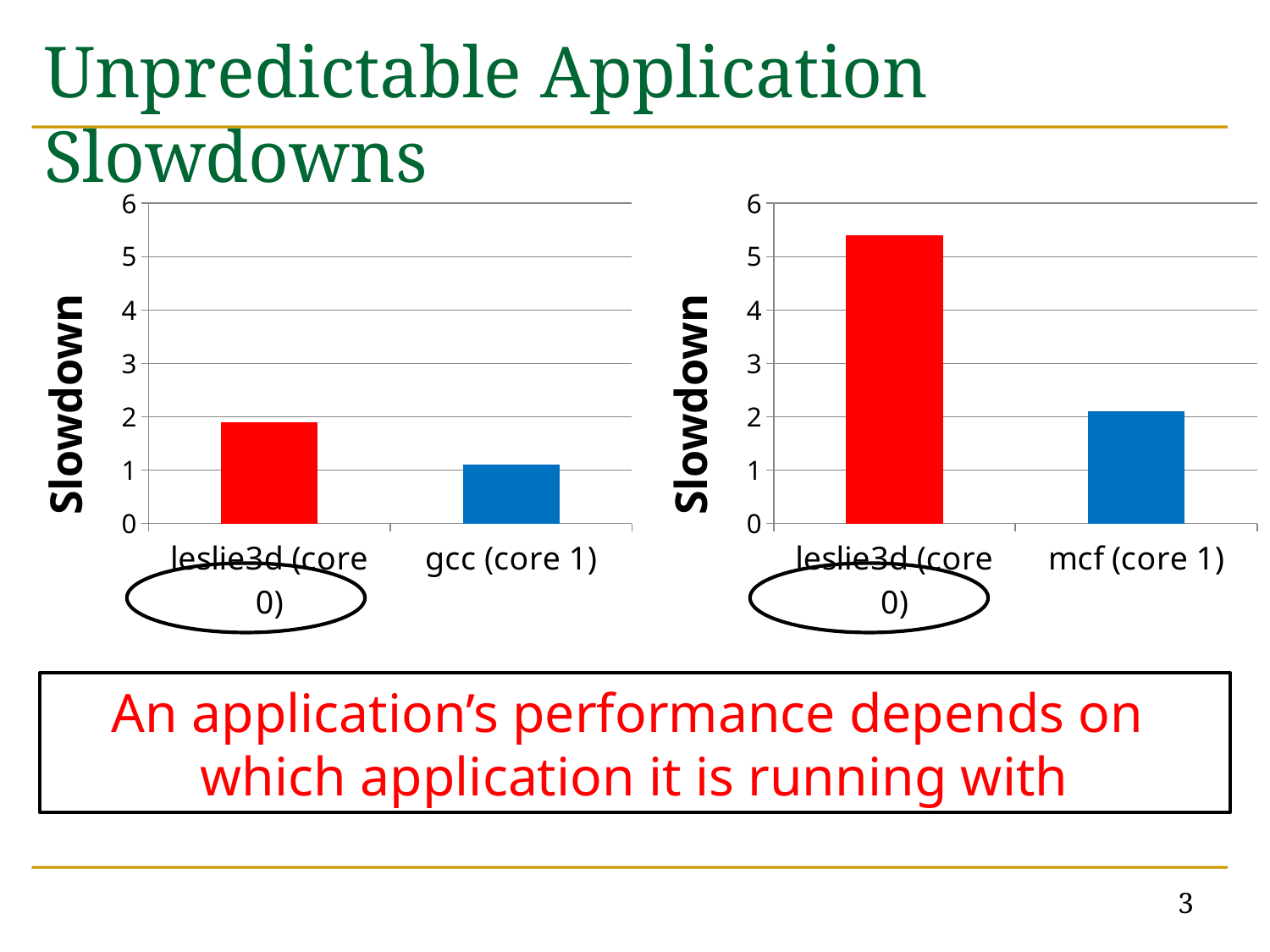
In the right chart, which category has the lowest slowdown? mcf (core 1) What type of chart is the left chart on the slide? bar chart In the left chart, which category has the lowest slowdown? gcc (core 1) What is the y-axis label of the left chart? Slowdown In the right chart, is the slowdown for leslie3d (core 0) greater or less than 5? greater In the left chart, is the slowdown for gcc (core 1) greater or less than 2? less In the left chart, is the slowdown for leslie3d (core 0) greater or less than 1? greater In the left chart, which category has the highest slowdown? leslie3d (core 0) In the right chart, which category has the highest slowdown? leslie3d (core 0) Is the slowdown for leslie3d (core 0) larger in the left chart or the right chart? right chart How many categories are shown in the right chart? 2